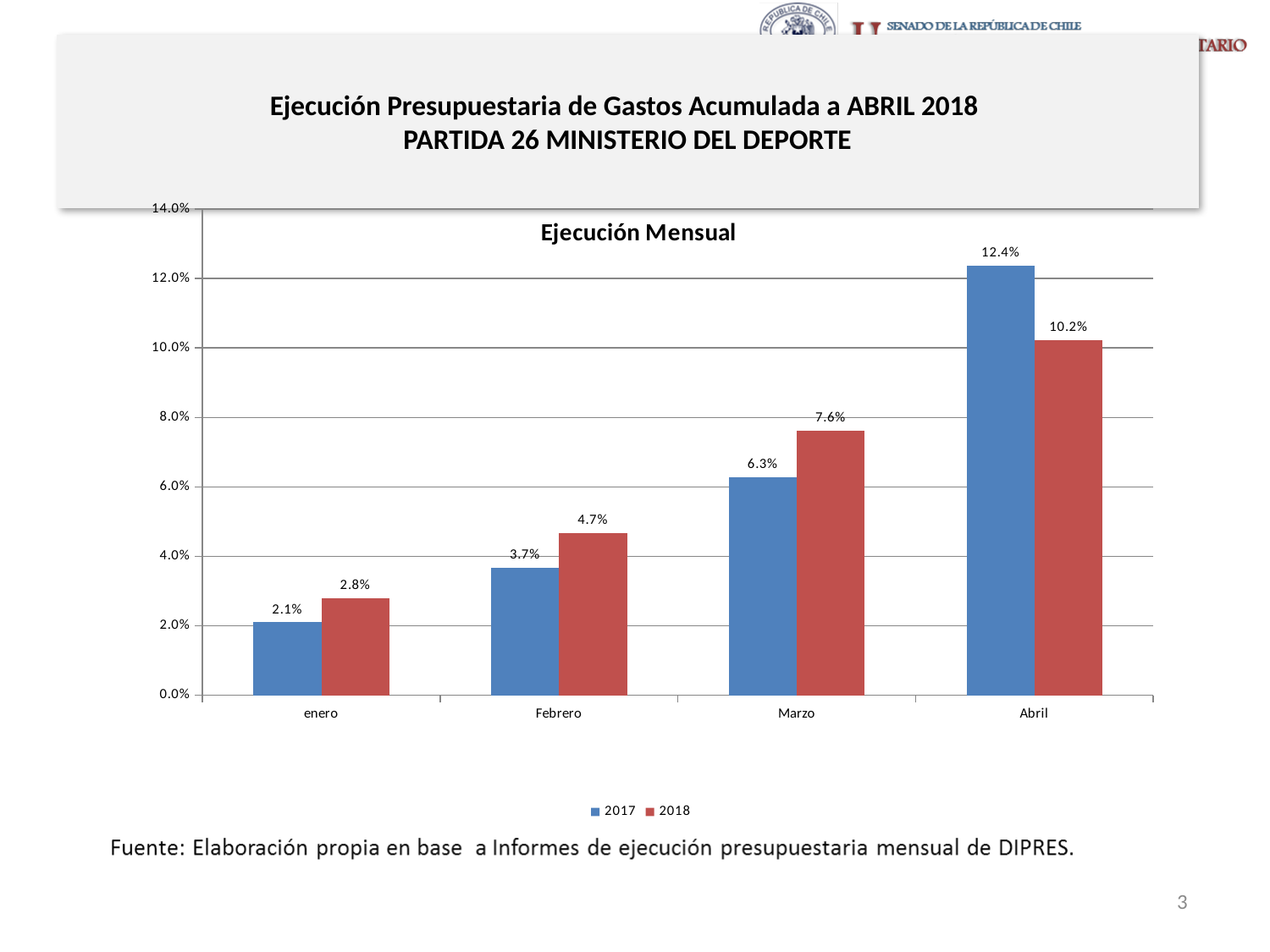
How many series does the legend list? 2 What kind of chart is shown? bar chart Is the value for 2017 in Marzo greater or less than 8.0%? less What is the value for 2018 in enero? 2.8% How many months are shown on the x axis? 4 Do the 2018 values rise or fall from enero to Abril? rise Which is larger in Abril, the 2017 value or the 2018 value? 2017 What is the value for 2018 in Febrero? 4.7% What is the difference between the 2017 and 2018 values in Marzo? 1.3% What is the value for 2017 in Abril? 12.4% Which month has the highest value for the 2018 series? Abril Which month has the lowest value for the 2017 series? enero